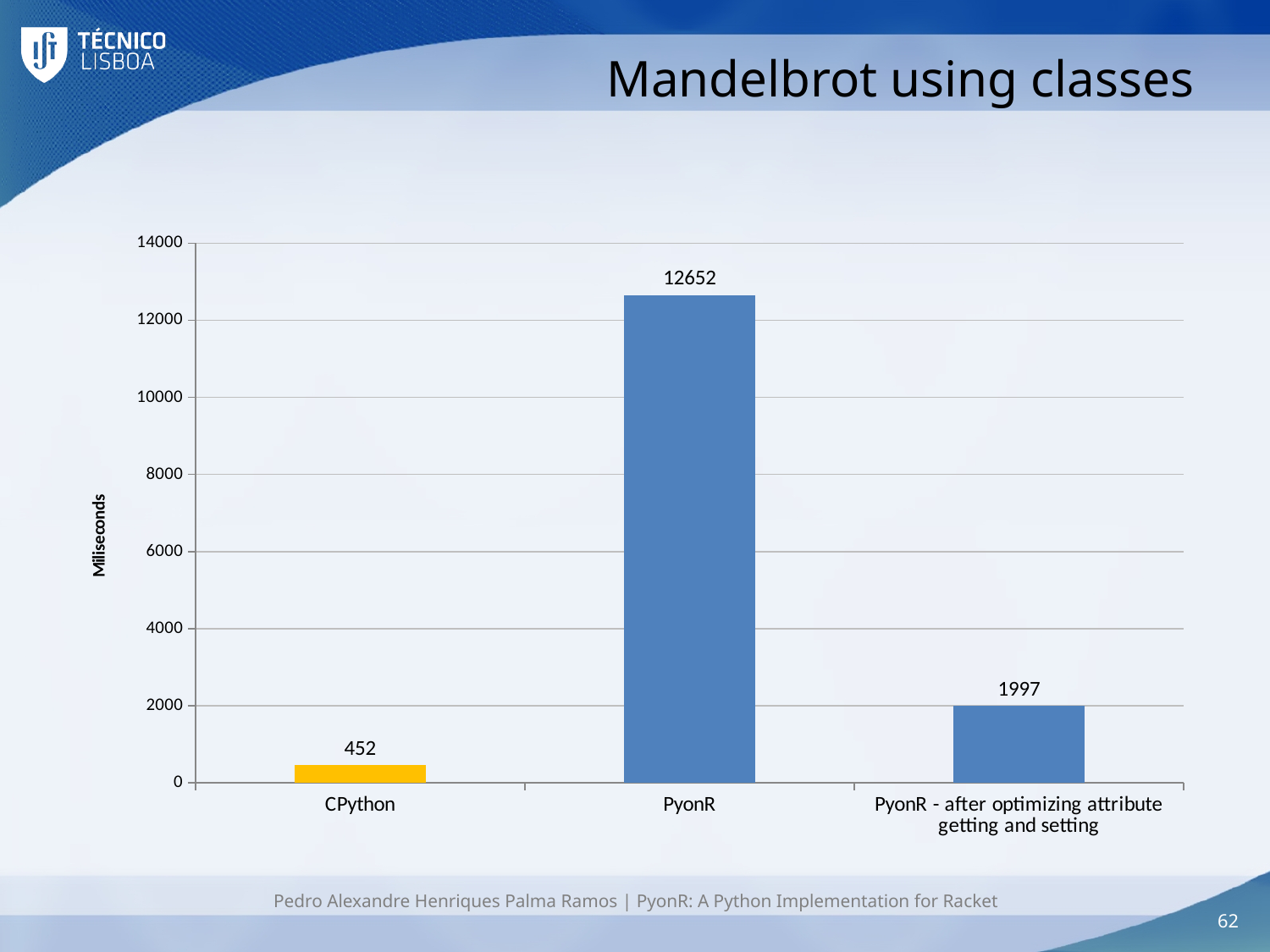
Which category has the highest value? PyonR How many categories are shown on the x axis? 3 Which is larger, the value for CPython or the value for PyonR - after optimizing attribute getting and setting? PyonR - after optimizing attribute getting and setting What is the difference between the values for PyonR and PyonR - after optimizing attribute getting and setting? 10655 Which category has the lowest value? CPython What kind of chart is shown on the slide? bar chart What is the difference between the values for PyonR and CPython? 12200 What is the label of the vertical axis? Miliseconds Is the value for PyonR greater or less than 12000? greater What is the value for CPython? 452 What is the value for PyonR - after optimizing attribute getting and setting? 1997 What is the value for PyonR? 12652